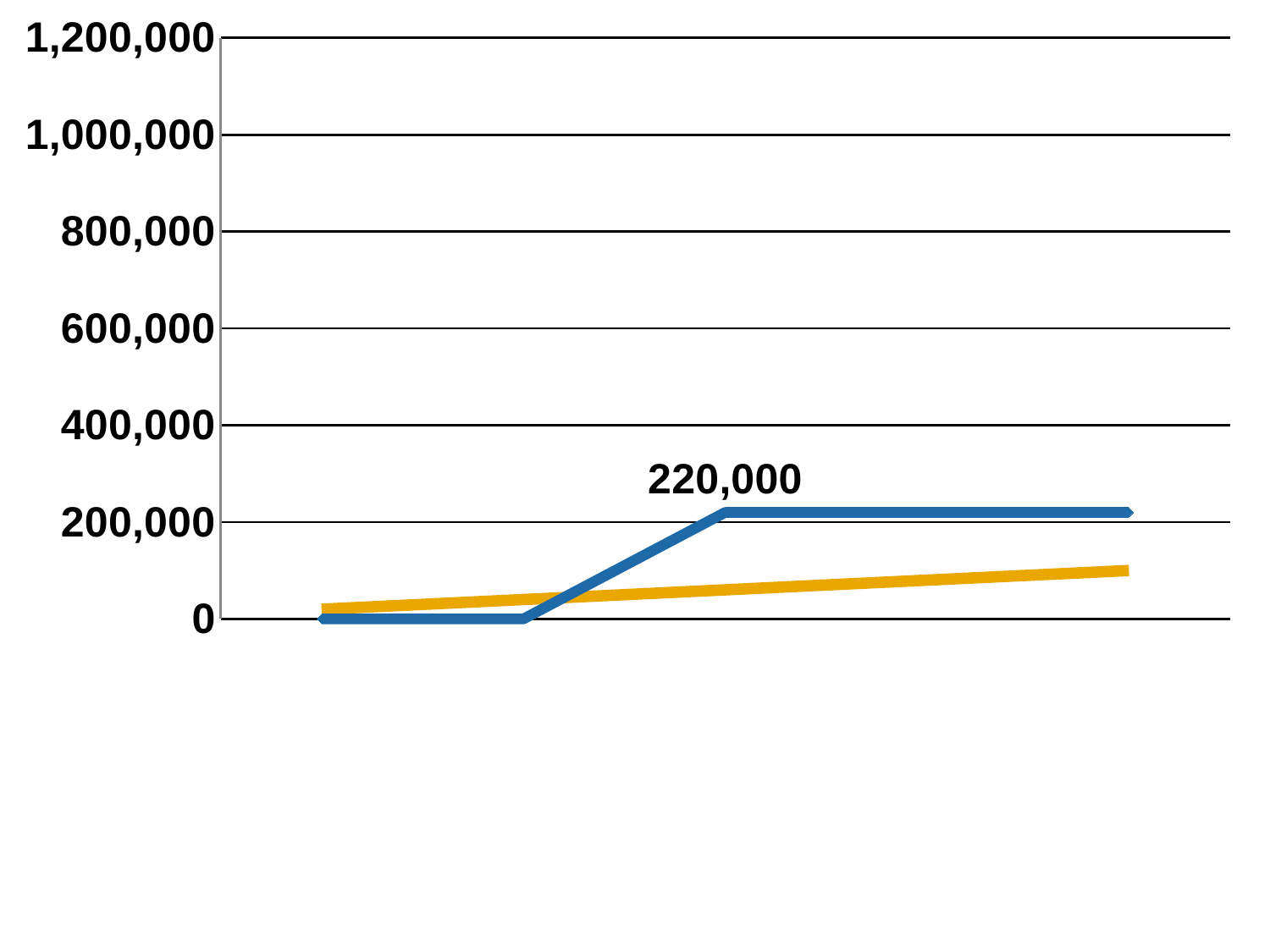
What is the highest value shown on the vertical axis? 1,200,000 Does the yellow line rise or fall from left to right? rise At the rightmost point, which line is higher, the blue line or the yellow line? blue line Is the value of the yellow line at its rightmost point greater or less than 200,000? less What is the highest value reached by the blue line? 220,000 What value is printed as a data label on the blue line? 220,000 How many lines are plotted on the chart? 2 What colours are the two lines on the chart? blue and yellow What kind of chart is shown on the slide? line chart Is the labelled value on the blue line greater or less than 400,000? less At the leftmost point, which line is higher, the blue line or the yellow line? yellow line